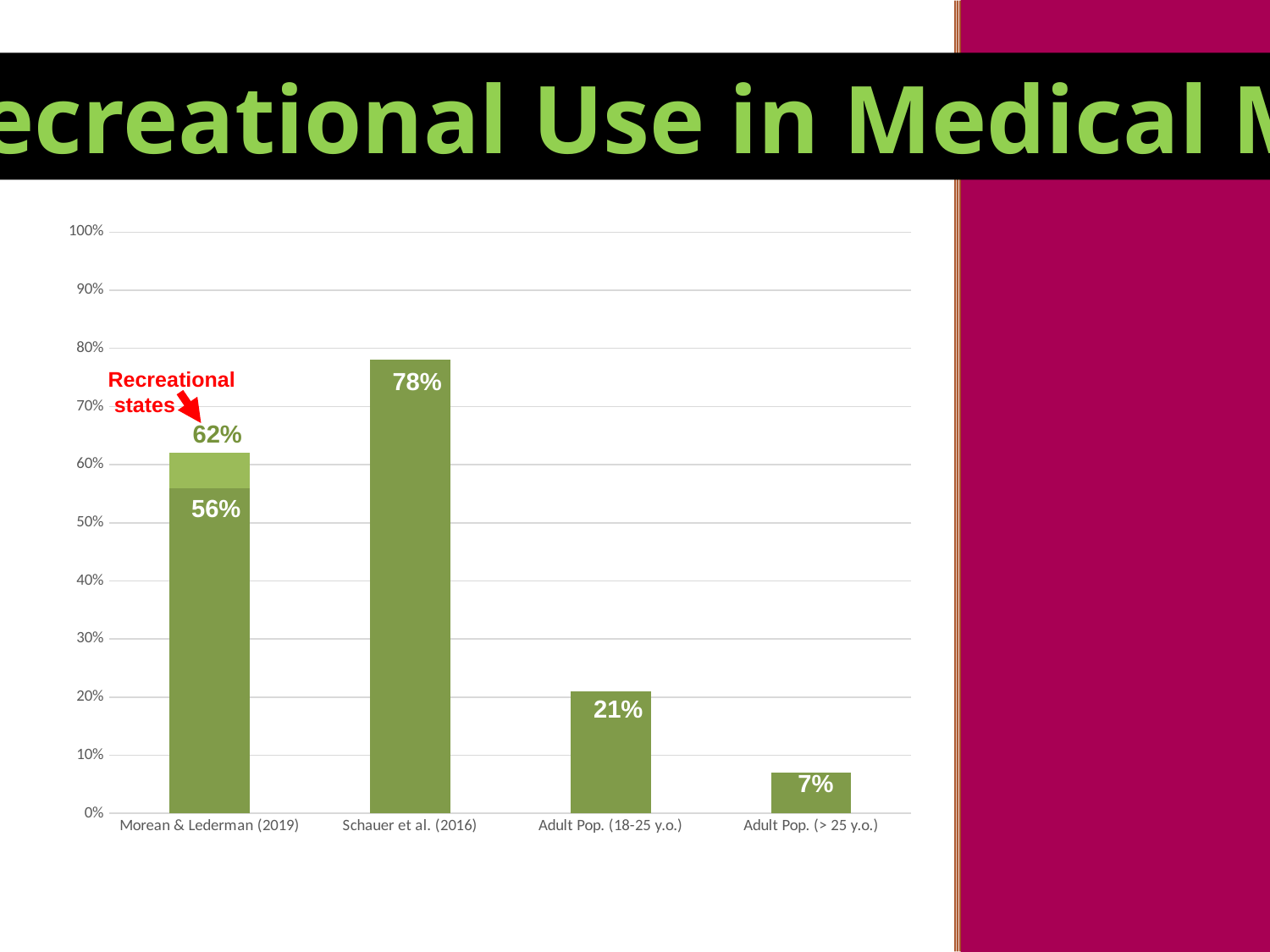
Which is larger, the value for Schauer et al. (2016) or the 56% value for Morean & Lederman (2019)? Schauer et al. (2016) What is the value for Schauer et al. (2016)? 78% What kind of chart is shown on the slide? Bar chart Which category has the highest value? Schauer et al. (2016) What is the value labeled on the dark green bar for Morean & Lederman (2019)? 56% How many categories are shown on the x axis? 4 What is the value for Adult Pop. (> 25 y.o.)? 7% Which category has the lowest value? Adult Pop. (> 25 y.o.) What is the value for Adult Pop. (18-25 y.o.)? 21% What is the difference between the values for Schauer et al. (2016) and Adult Pop. (18-25 y.o.)? 57% What value is labeled for the 'Recreational states' portion of the Morean & Lederman (2019) bar? 62% What is the difference between the values for Adult Pop. (18-25 y.o.) and Adult Pop. (> 25 y.o.)? 14%